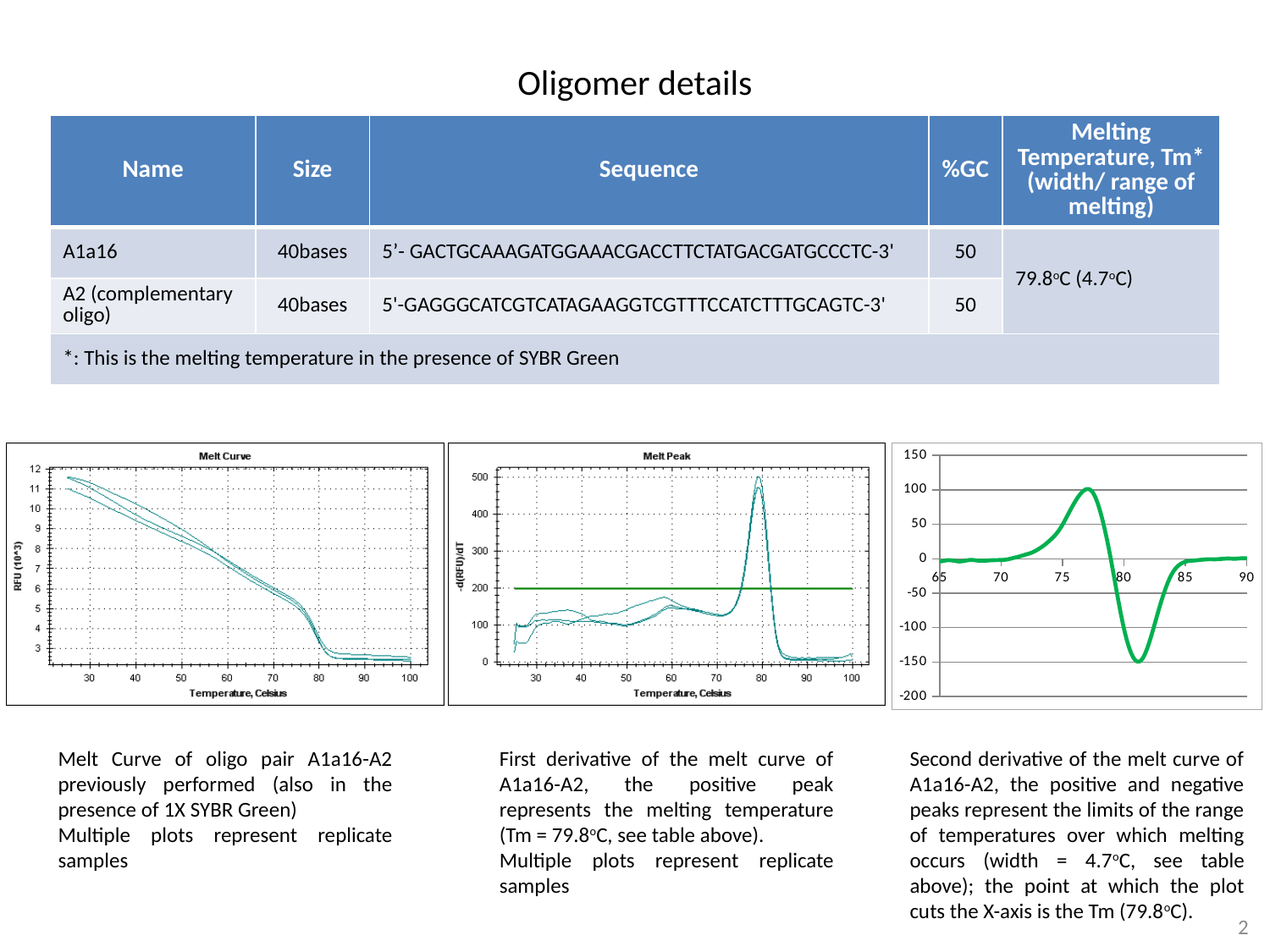
What kind of chart is the Melt Curve chart on the left? line chart In the rightmost chart (second derivative), is the value of the negative peak greater or less than -100? less How many tick labels are shown on the x axis of the rightmost chart (second derivative)? 6 In the rightmost chart (second derivative), does the curve rise or fall between 70 and 75 on the x axis? rise In the Melt Curve chart, do the values rise or fall as temperature increases along the x axis? fall In the Melt Curve chart, is the RFU value at 30 degrees Celsius greater or less than 10? greater What is the y-axis label of the Melt Peak chart? -d(RFU)/dT What is the x-axis label of the Melt Curve chart? Temperature, Celsius In the rightmost chart (second derivative), is the value of the positive peak greater or less than 50? greater